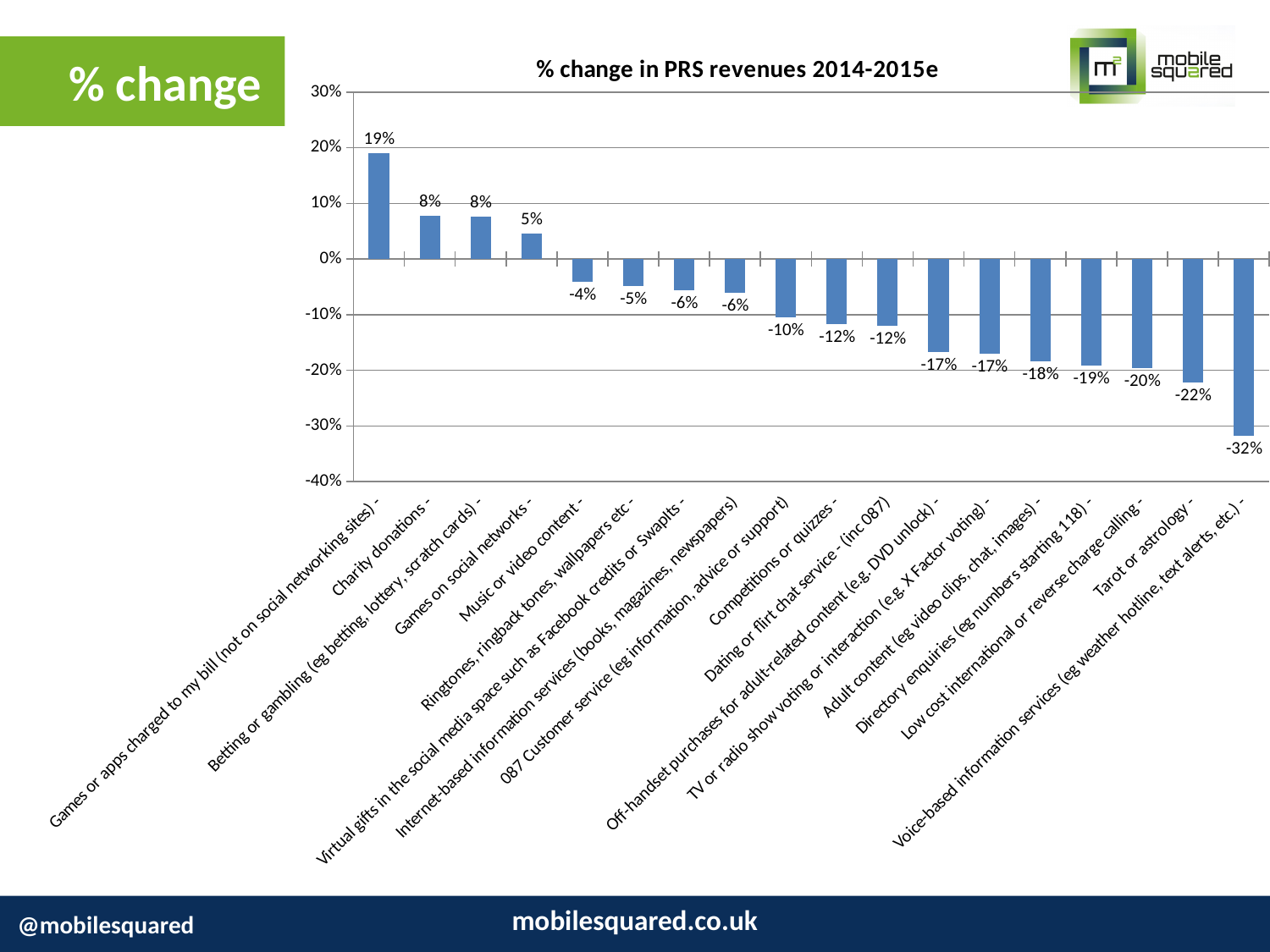
What is the % change in PRS revenues for Directory enquiries (eg numbers starting 118)? -19% Which has a larger % change in PRS revenues: Music or video content or Competitions or quizzes? Music or video content Which category has the lowest % change in PRS revenues 2014-2015e? Voice-based information services (eg weather hotline, text alerts, etc.) What is the % change in PRS revenues for Charity donations? 8% What is the difference between the % change for Games or apps charged to my bill (not on social networking sites) and Charity donations? 11 percentage points Which category has the highest % change in PRS revenues 2014-2015e? Games or apps charged to my bill (not on social networking sites) What is the % change in PRS revenues for Games on social networks? 5% What is the % change in PRS revenues for Tarot or astrology? -22% Is the value for Adult content (eg video clips, chat, images) greater or less than -10%? less What is the title of the chart? % change in PRS revenues 2014-2015e How many categories are shown in the chart? 18 What kind of chart is shown on the slide? Bar chart